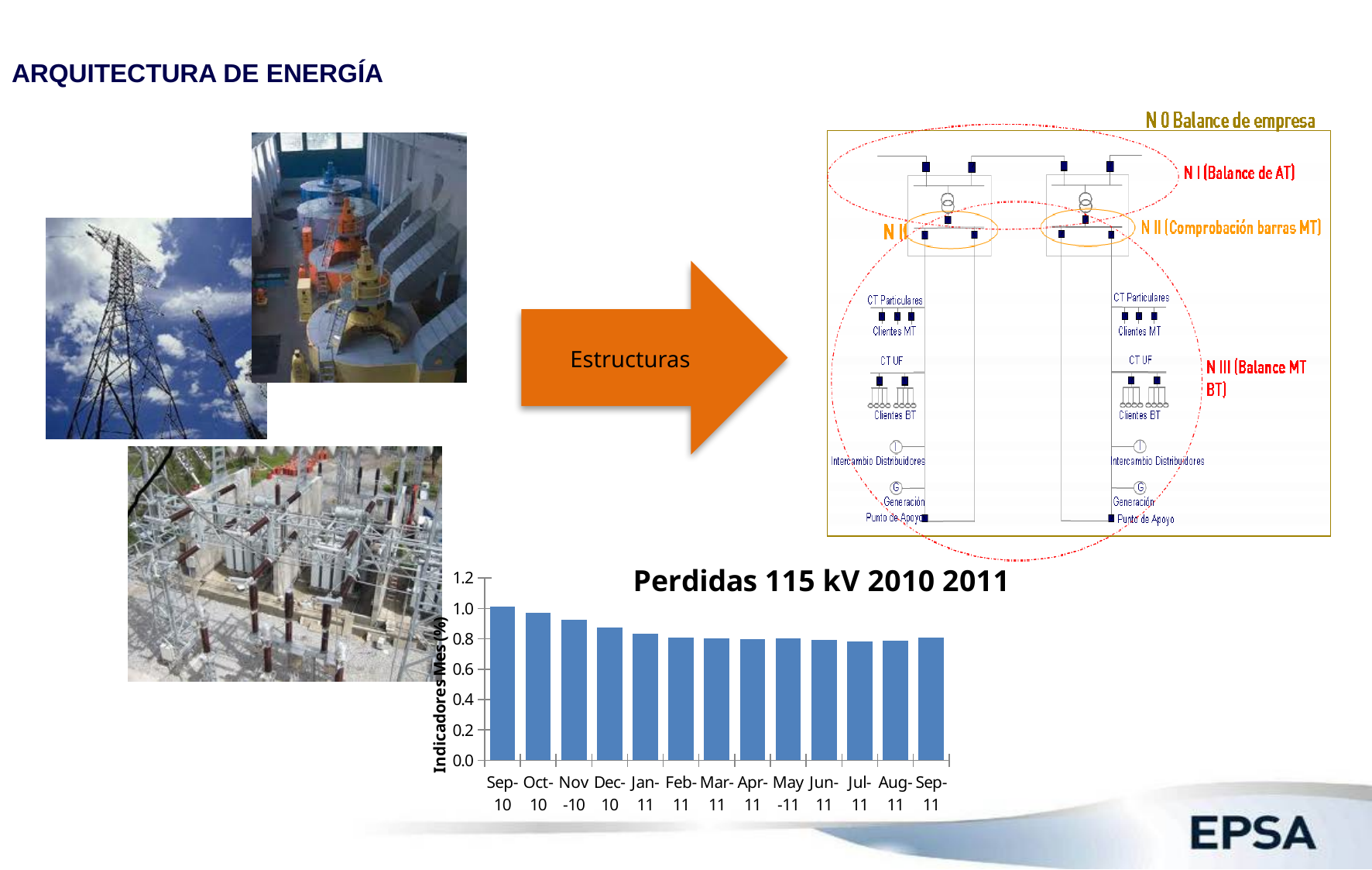
In the "Perdidas 115 kV 2010 2011" chart, which is larger, the value for Oct-10 or the value for Jul-11? Oct-10 In the "Perdidas 115 kV 2010 2011" chart, is the value for Feb-11 greater or less than 1.0? less In the "Perdidas 115 kV 2010 2011" chart, is the value for Dec-10 greater or less than 0.6? greater What type of chart is shown under the title "Perdidas 115 kV 2010 2011"? bar chart What is the title of the bar chart on the slide? Perdidas 115 kV 2010 2011 What is the label on the vertical axis of the "Perdidas 115 kV 2010 2011" chart? Indicadores Mes (%) Do the values in the "Perdidas 115 kV 2010 2011" chart generally rise or fall from Sep-10 to Sep-11? fall Which month has the highest value in the "Perdidas 115 kV 2010 2011" chart? Sep-10 In the "Perdidas 115 kV 2010 2011" chart, is the value for Sep-10 greater or less than 1.2? less In the "Perdidas 115 kV 2010 2011" chart, which is larger, the value for Sep-10 or the value for Sep-11? Sep-10 How many months (bars) are plotted in the "Perdidas 115 kV 2010 2011" chart? 13